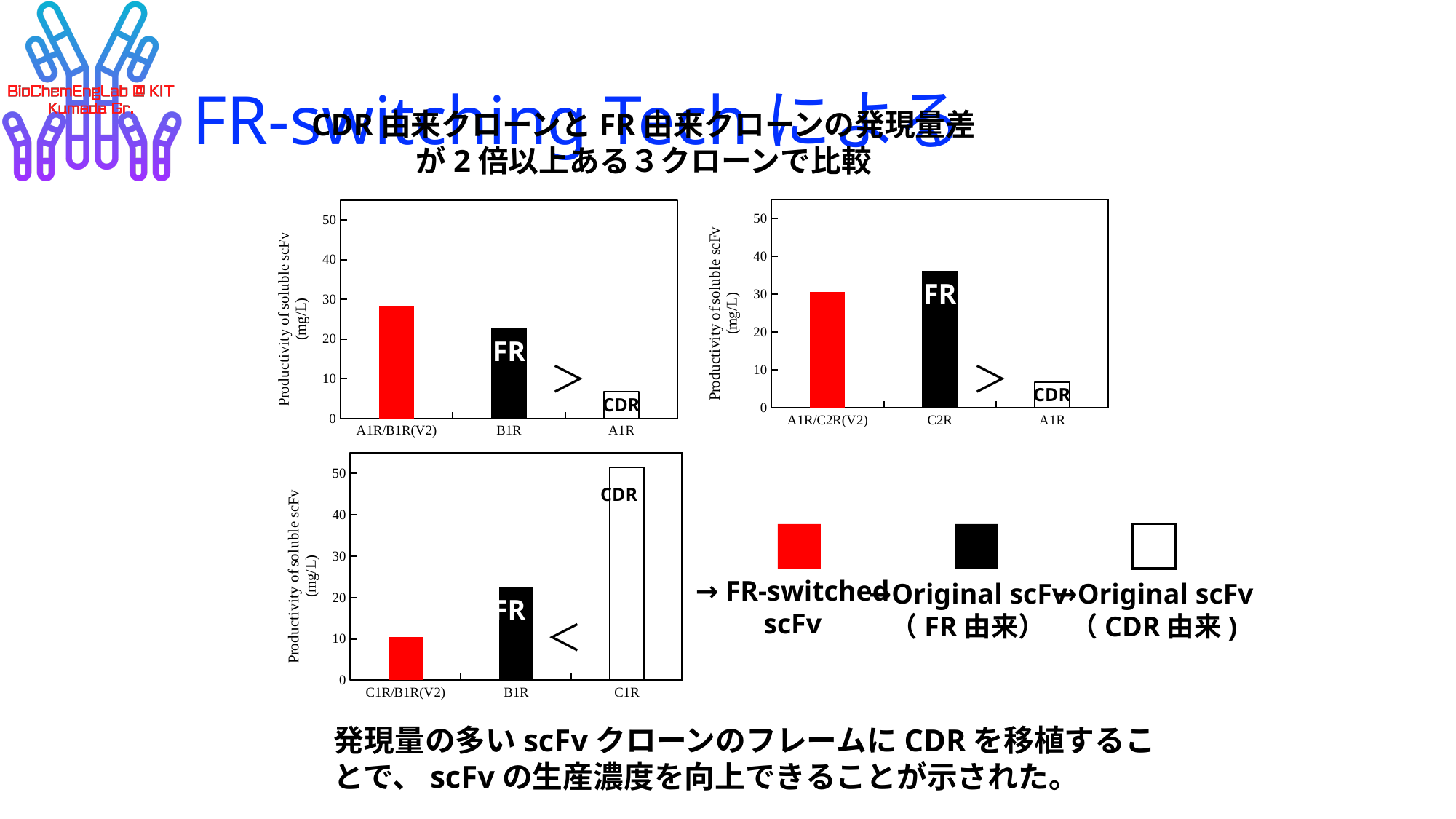
What kind of chart is the top-right chart? bar chart In the top-left chart, is the value for A1R greater or less than 10? less In the top-left chart, which category has the lowest bar? A1R In the top-right chart, which category has the highest bar? C2R In the top-left chart, is the value for B1R greater or less than 20? greater In the bottom-left chart, which category has the highest bar? C1R In the top-left chart, which category has the highest bar? A1R/B1R(V2) In the bottom-left chart, which category has the lowest bar? C1R/B1R(V2) In the top-right chart, which is larger, the value for C2R or the value for A1R? C2R How many categories are shown in the bottom-left chart? 3